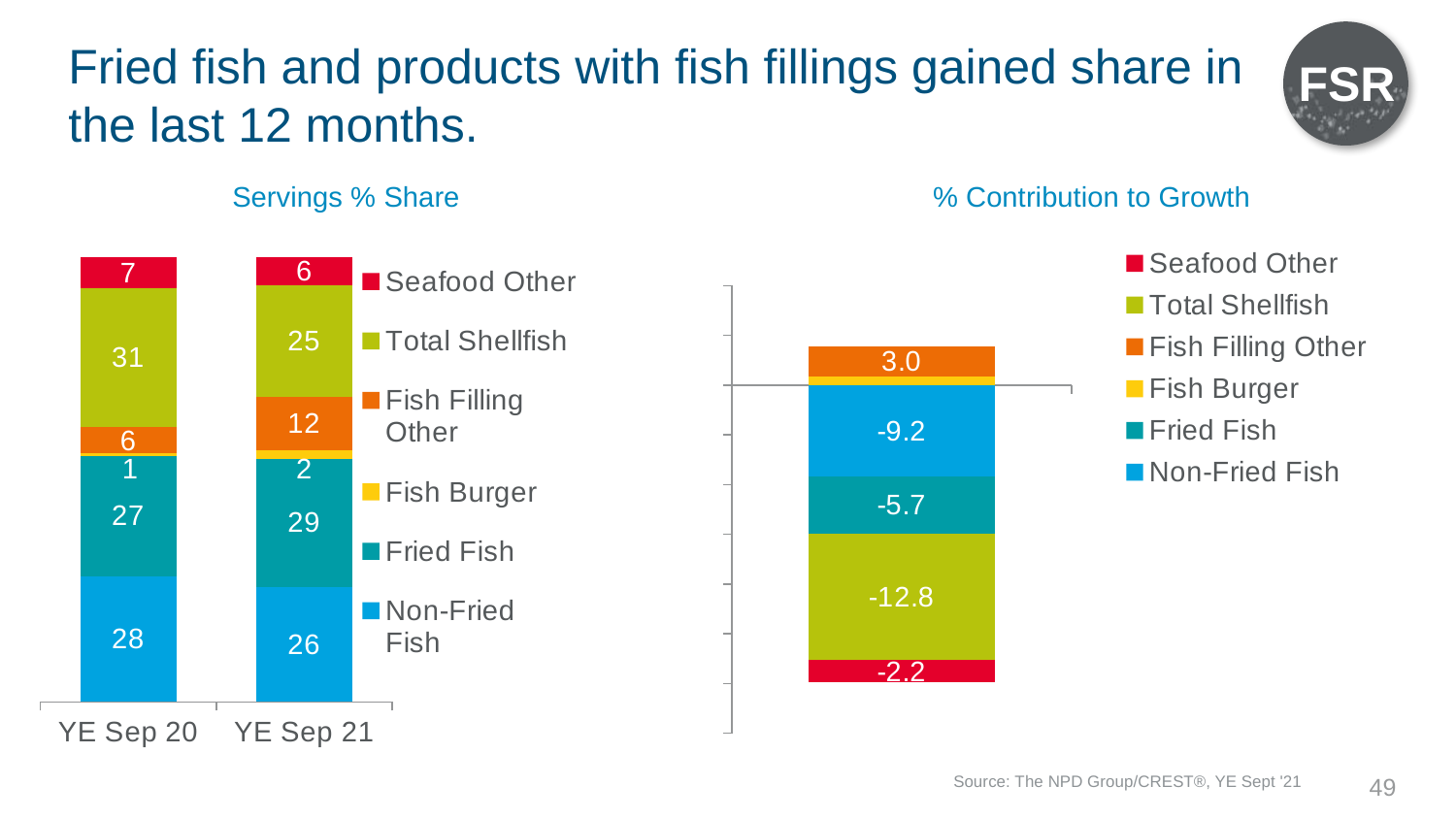
How many series does the legend of the Servings % Share chart list? 6 In the Servings % Share chart, what is the value for Fish Filling Other in YE Sep 21? 12 In the % Contribution to Growth chart, which series has the lowest (most negative) value? Total Shellfish In the Servings % Share chart, by how much did the Total Shellfish share fall from YE Sep 20 to YE Sep 21? 6 In the Servings % Share chart, what is the value for Total Shellfish in YE Sep 21? 25 In the % Contribution to Growth chart, what is the value for Non-Fried Fish? -9.2 How many time periods are shown on the x axis of the Servings % Share chart? 2 In the Servings % Share chart, what is the value for Non-Fried Fish in YE Sep 20? 28 What kind of chart is the Servings % Share chart? Stacked bar chart In the % Contribution to Growth chart, what is the value for Total Shellfish? -12.8 In the Servings % Share chart, is the Fried Fish share larger in YE Sep 20 or YE Sep 21? YE Sep 21 In the % Contribution to Growth chart, what is the value for Fish Filling Other? 3.0